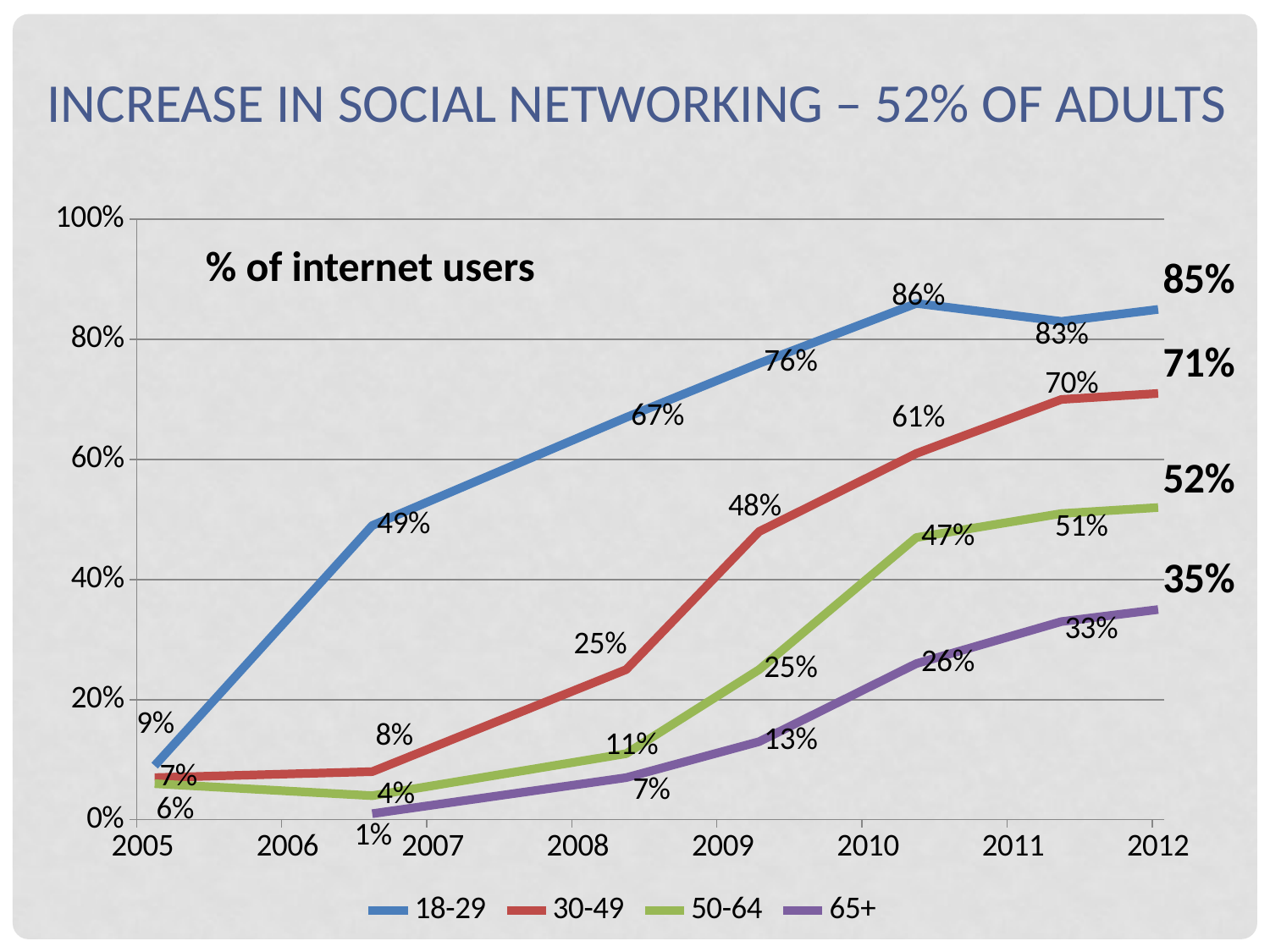
What is the value for the 65+ series in 2012? 35% Which age group has the highest value in 2012? 18-29 What is the value for the 30-49 series in 2012? 71% What kind of chart is shown on the slide? line chart Does the 65+ series rise or fall from 2007 to 2012? rise Which age group has the lowest value in 2012? 65+ What is the value for the 18-29 series in 2012? 85% How many series does the legend list? 4 What text label appears inside the plot area near the top left? % of internet users What is the highest labelled value reached by the 18-29 series? 86% What is the difference between the 18-29 and 65+ values in 2012? 50% Which is larger in 2012, the 30-49 value or the 50-64 value? 30-49